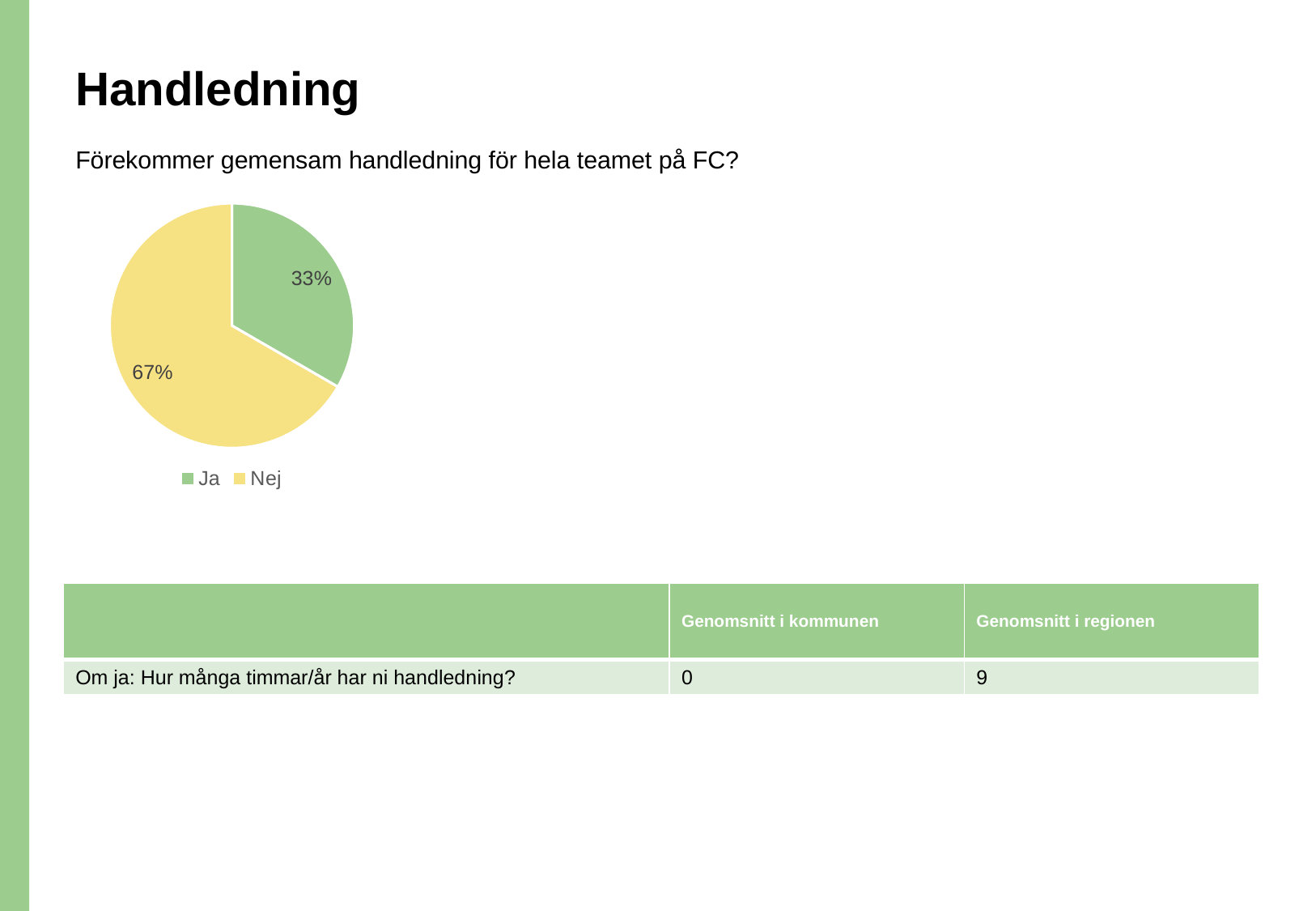
Which is larger, the "Ja" slice or the "Nej" slice? Nej What colour is the "Ja" slice? green What colour is the "Nej" slice? yellow What kind of chart is shown on the slide? pie chart What share of the pie does "Nej" represent? 67% What is the difference in percentage points between the "Nej" and "Ja" slices? 34 How many entries does the legend list? 2 What share of the pie does "Ja" represent? 33% Which slice of the pie is the smallest? Ja Which slice of the pie is the largest? Nej How many slices does the pie chart have? 2